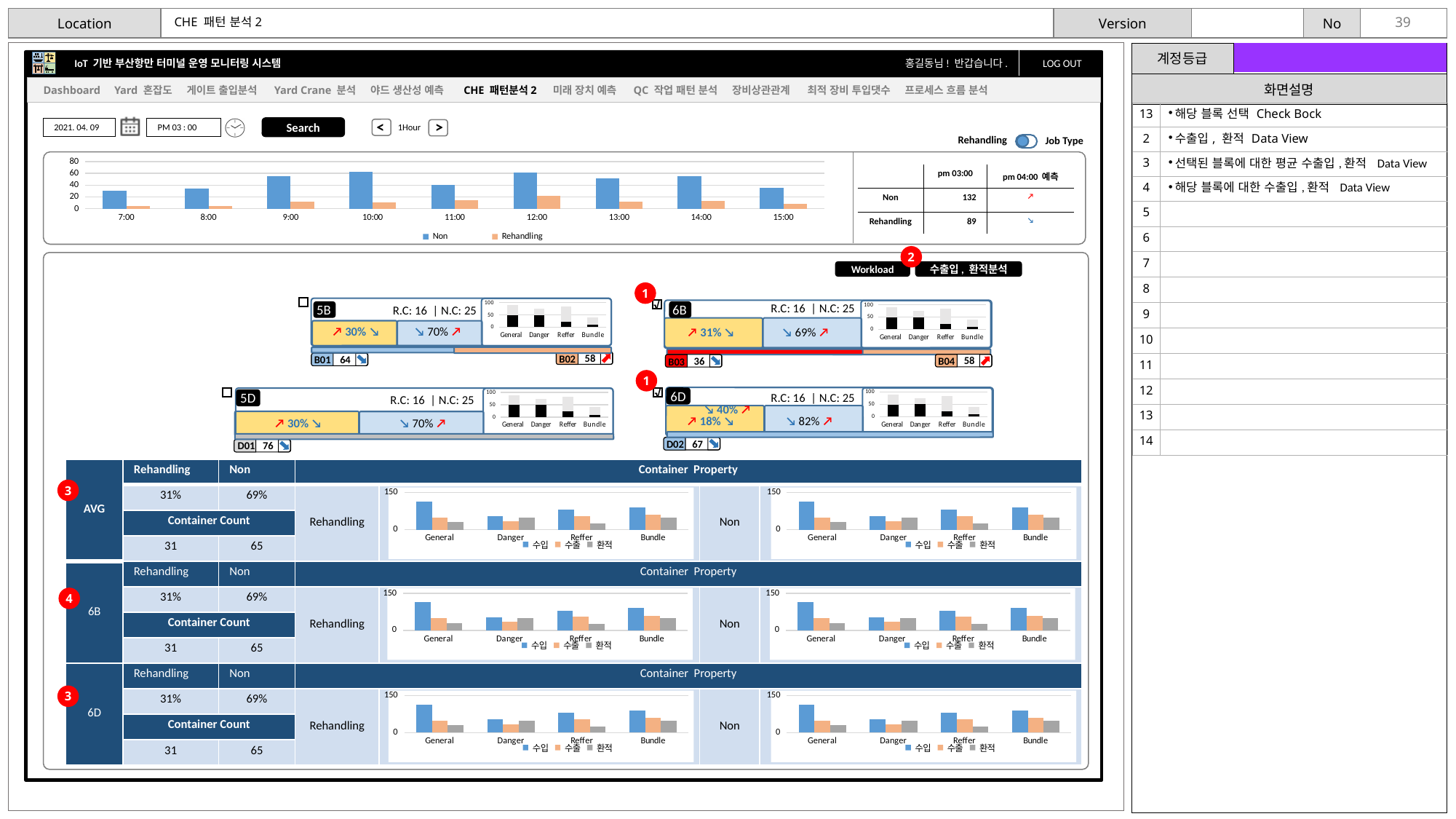
In the top chart, which is larger, the Non value at 9:00 or the Non value at 7:00? 9:00 In the top chart, is the Rehandling value at 7:00 greater or less than 20? less What are the two legend entries of the top chart? Non, Rehandling In the top chart, at which hour is the Rehandling value highest? 12:00 In the top chart, is the Non value at 7:00 greater or less than 40? less In the top chart, is the Non value at 9:00 greater or less than 40? greater What kind of chart is the top chart showing Non and Rehandling by hour? bar chart In the top chart, which is larger at 12:00, Non or Rehandling? Non How many series does the legend of the top chart list? 2 In the AVG row's Rehandling Container Property chart, how many categories are on the x axis? 4 In the AVG row's Rehandling Container Property chart, how many series does the legend list? 3 In the top bar chart, how many time points are shown on the x axis? 9